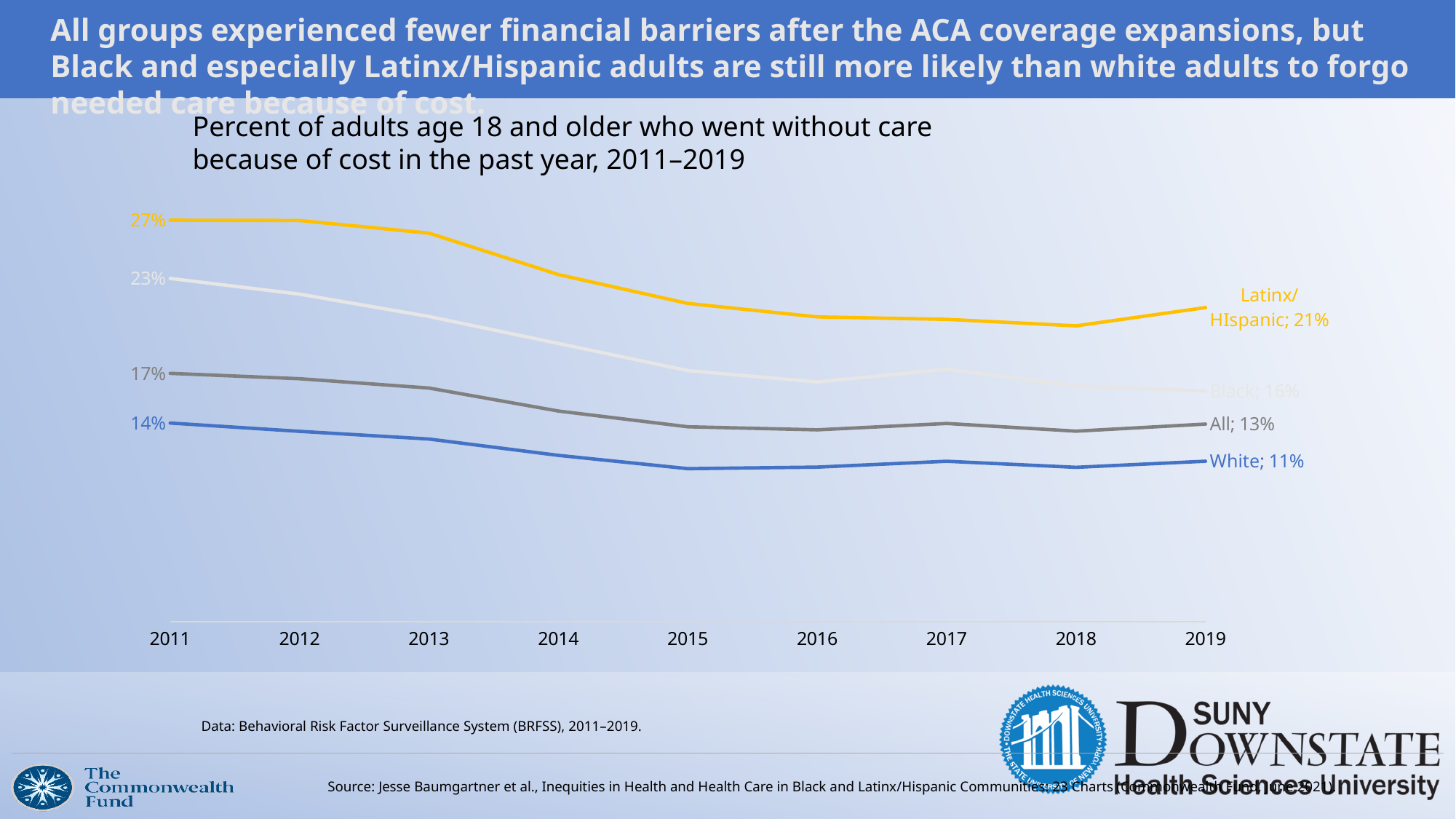
Which group had the highest percent of adults going without care because of cost in 2019? Latinx/Hispanic Did the percent of White adults going without care because of cost rise or fall from 2011 to 2019? fall How many years are shown on the x axis? 9 What is the difference between the Black and White values in 2019? 5 percentage points By how many percentage points did the Latinx/Hispanic value fall from 2011 to 2019? 6 percentage points What was the percent of Latinx/Hispanic adults who went without care because of cost in 2011? 27% What type of chart is shown on the slide? line chart What was the value for All adults in 2019? 13% Which group had the lowest percent of adults going without care because of cost in 2011? White What was the percent of Latinx/Hispanic adults who went without care because of cost in 2019? 21% What was the value for Black adults in 2019? 16% What was the value for White adults in 2011? 14%